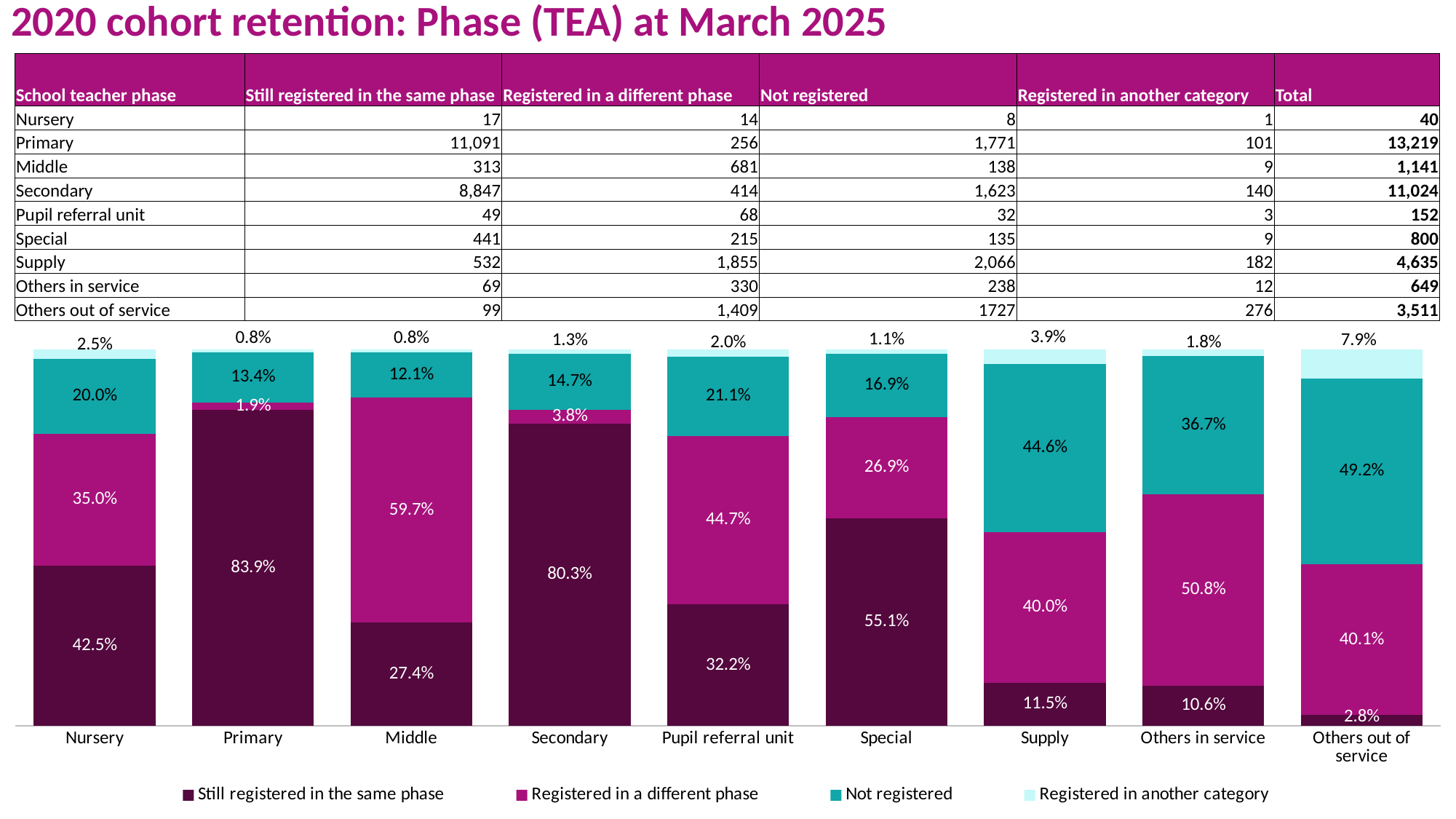
Which phase has the lowest 'Still registered in the same phase' share? Others out of service What percentage of the Primary bar is 'Still registered in the same phase'? 83.9% What is the 'Not registered' share for Supply in the chart? 44.6% What is the difference between the 'Still registered in the same phase' shares for Secondary and Middle? 52.9 percentage points How many phases are shown on the x axis of the chart? 9 What type of chart is shown on the slide? Stacked bar chart Which phase has the highest 'Still registered in the same phase' share? Primary How many series does the chart legend list? 4 Is the 'Not registered' share larger for Supply or for Others in service? Supply What is the 'Registered in a different phase' share for Middle? 59.7% Which phase has the highest 'Not registered' share? Others out of service What is the 'Registered in another category' share for Others out of service? 7.9%